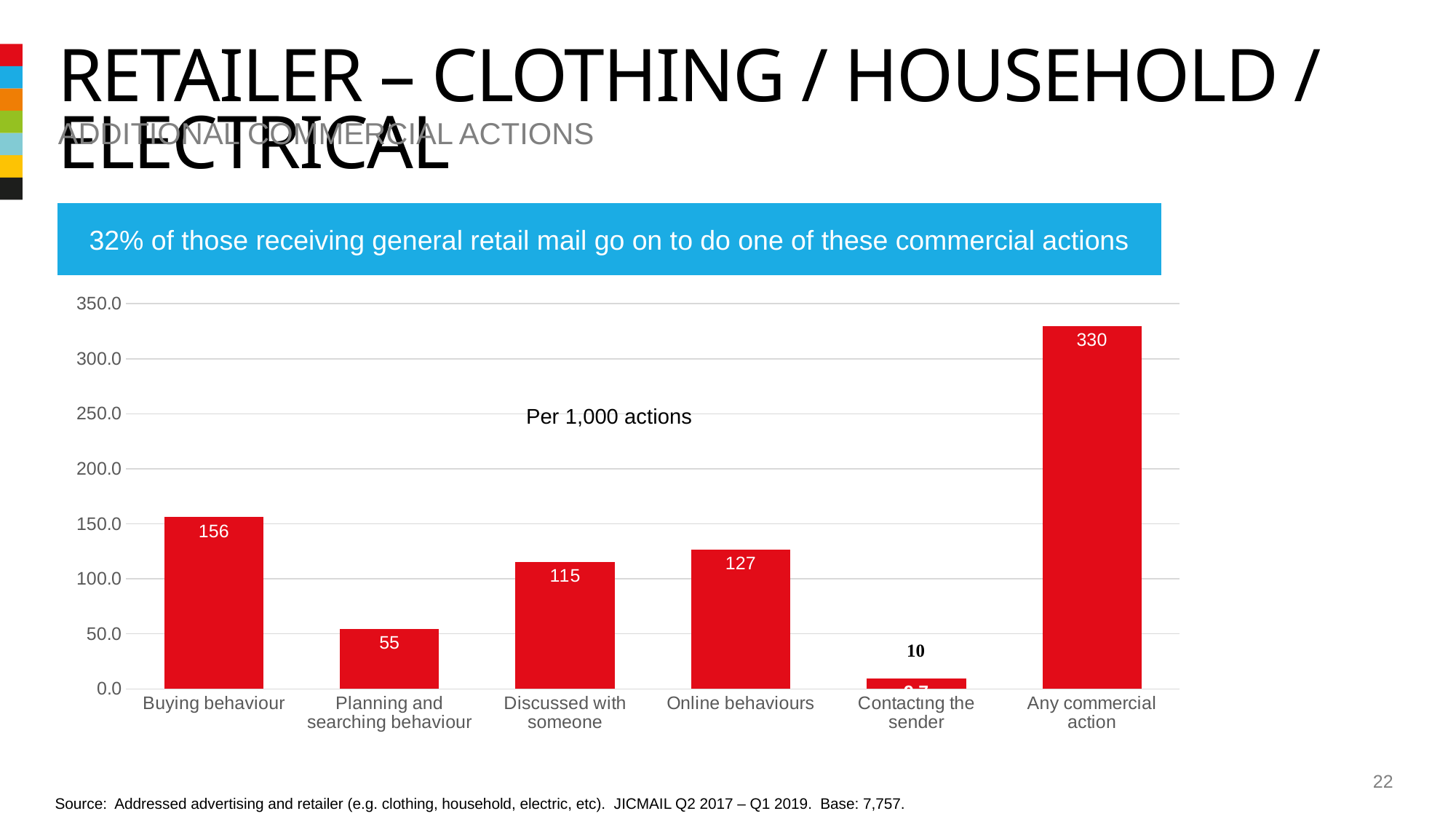
What is the value for Planning and searching behaviour? 55 What is the difference between the values for Buying behaviour and Online behaviours? 29 Is the value for Contacting the sender greater or less than 50? less What kind of chart is shown on the slide? Bar chart How many categories are shown on the x axis? 6 What is the value for Discussed with someone? 115 What is the value for Any commercial action? 330 Which category has the lowest value? Contacting the sender Which is larger, the value for Discussed with someone or the value for Online behaviours? Online behaviours What is the value for Buying behaviour? 156 What is the value for Online behaviours? 127 Which category has the highest value? Any commercial action